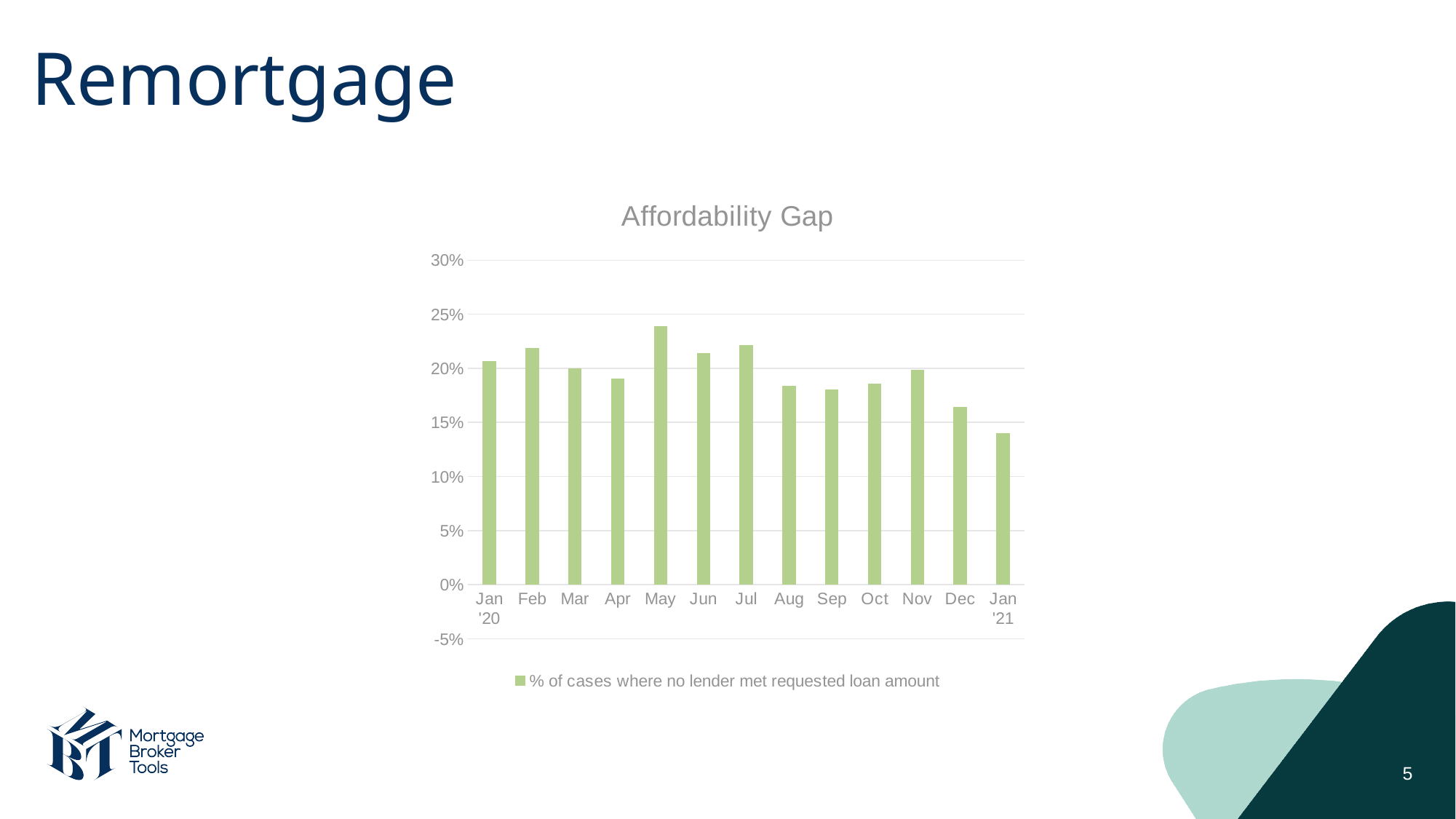
What series does the legend list? % of cases where no lender met requested loan amount Which is larger, the value for Feb or the value for Dec? Feb Do the values generally rise or fall from May to Jan '21? fall Which month has the highest value? May Is the value for Jan '21 greater or less than 15%? less How many months are plotted on the x axis? 13 How many series does the legend list? 1 Is the value for May greater or less than 20%? greater Which month has the lowest value? Jan '21 What type of chart is shown on the slide? Bar chart Is the value for Dec greater or less than 15%? greater What is the title of the chart? Affordability Gap